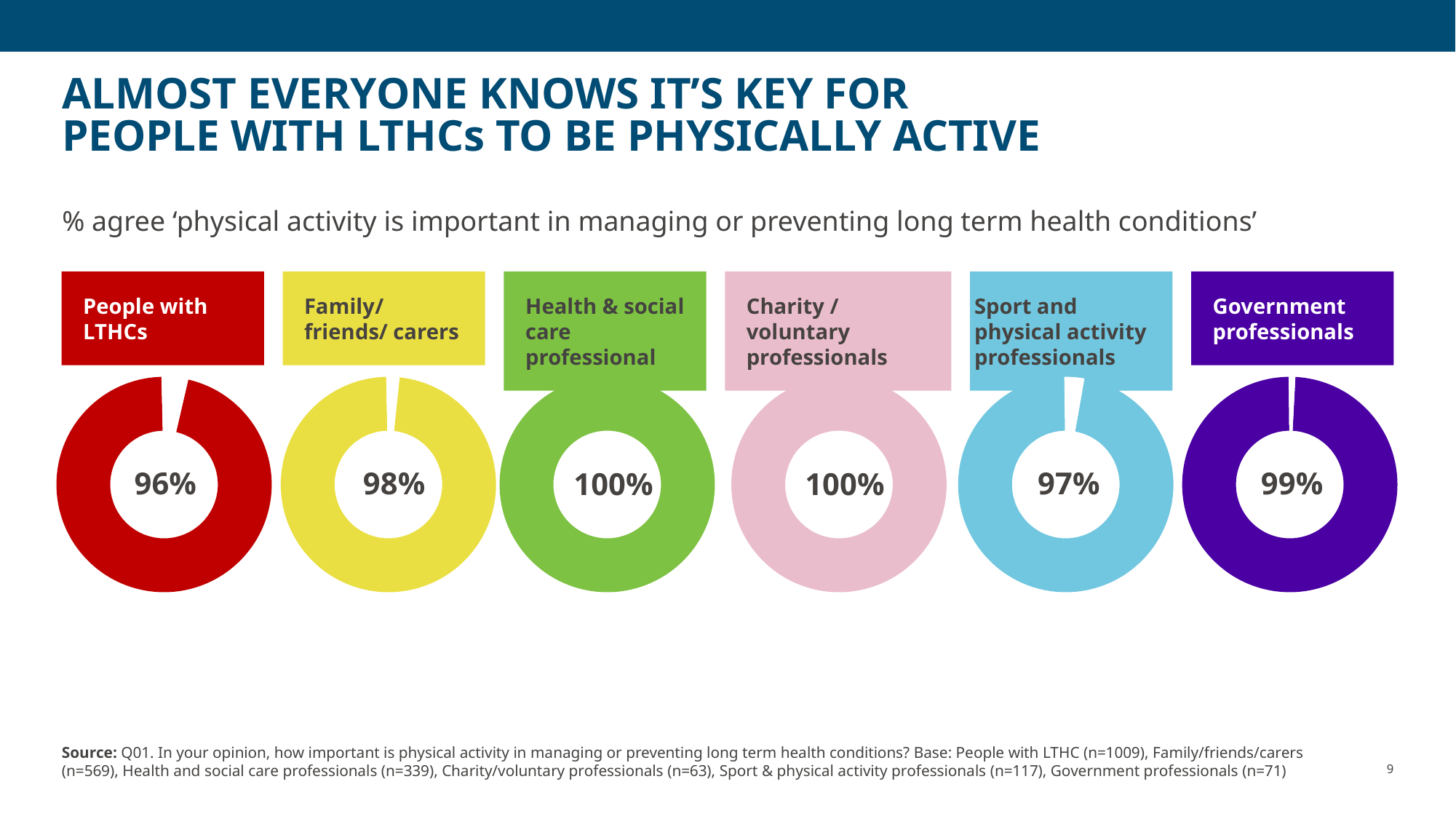
Which group has a higher agreement percentage: family/friends/carers or sport and physical activity professionals? Family/ friends/ carers What percentage of family/friends/carers agree that physical activity is important in managing or preventing long term health conditions? 98% Which two groups show 100% agreement? Health & social care professional and Charity / voluntary professionals What percentage of health & social care professionals agree that physical activity is important in managing or preventing long term health conditions? 100% What is the difference in percentage points between government professionals and people with LTHCs? 3 What colour is the doughnut chart for government professionals? Purple What percentage of people with LTHCs agree that physical activity is important in managing or preventing long term health conditions? 96% What percentage of government professionals agree that physical activity is important in managing or preventing long term health conditions? 99% Which group has the lowest percentage agreeing that physical activity is important in managing or preventing long term health conditions? People with LTHCs What percentage of sport and physical activity professionals agree that physical activity is important in managing or preventing long term health conditions? 97% What kind of chart is used to show each group's percentage? Doughnut chart How many groups are shown on the slide? 6